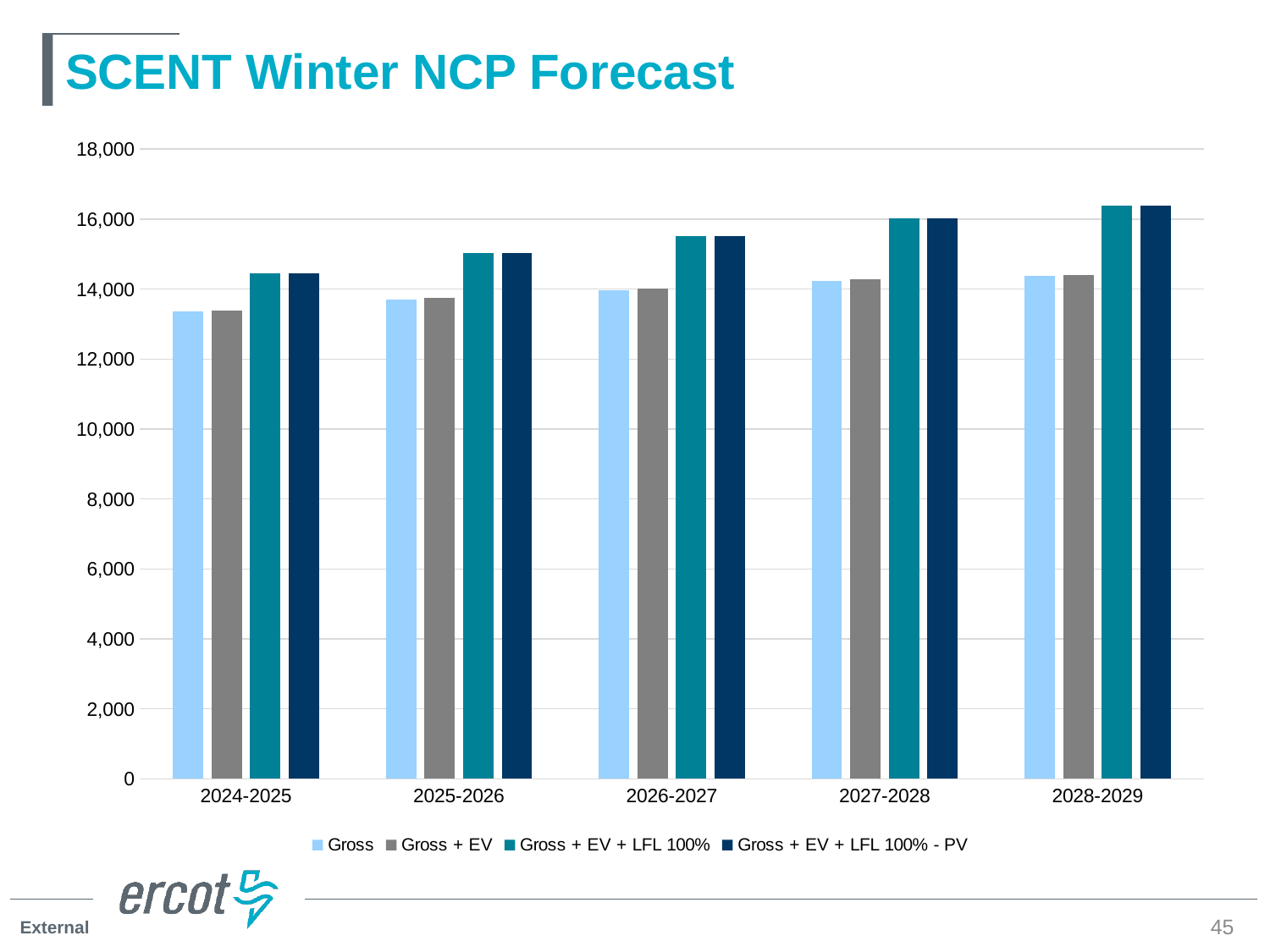
How many series does the legend list? 4 How many winter seasons (categories) are shown on the x axis? 5 Which winter season has the lowest Gross value? 2024-2025 Which winter season has the highest Gross + EV + LFL 100% value? 2028-2029 For 2028-2029, which is larger: the Gross value or the Gross + EV + LFL 100% value? Gross + EV + LFL 100% What is the title of the chart? SCENT Winter NCP Forecast What type of chart is shown on the slide? bar chart Is the Gross value for 2024-2025 greater or less than 14,000? less Is the Gross + EV + LFL 100% value for 2026-2027 greater or less than 16,000? less Do the Gross values rise or fall from 2024-2025 to 2028-2029? rise Is the Gross + EV + LFL 100% value for 2024-2025 greater or less than 14,000? greater